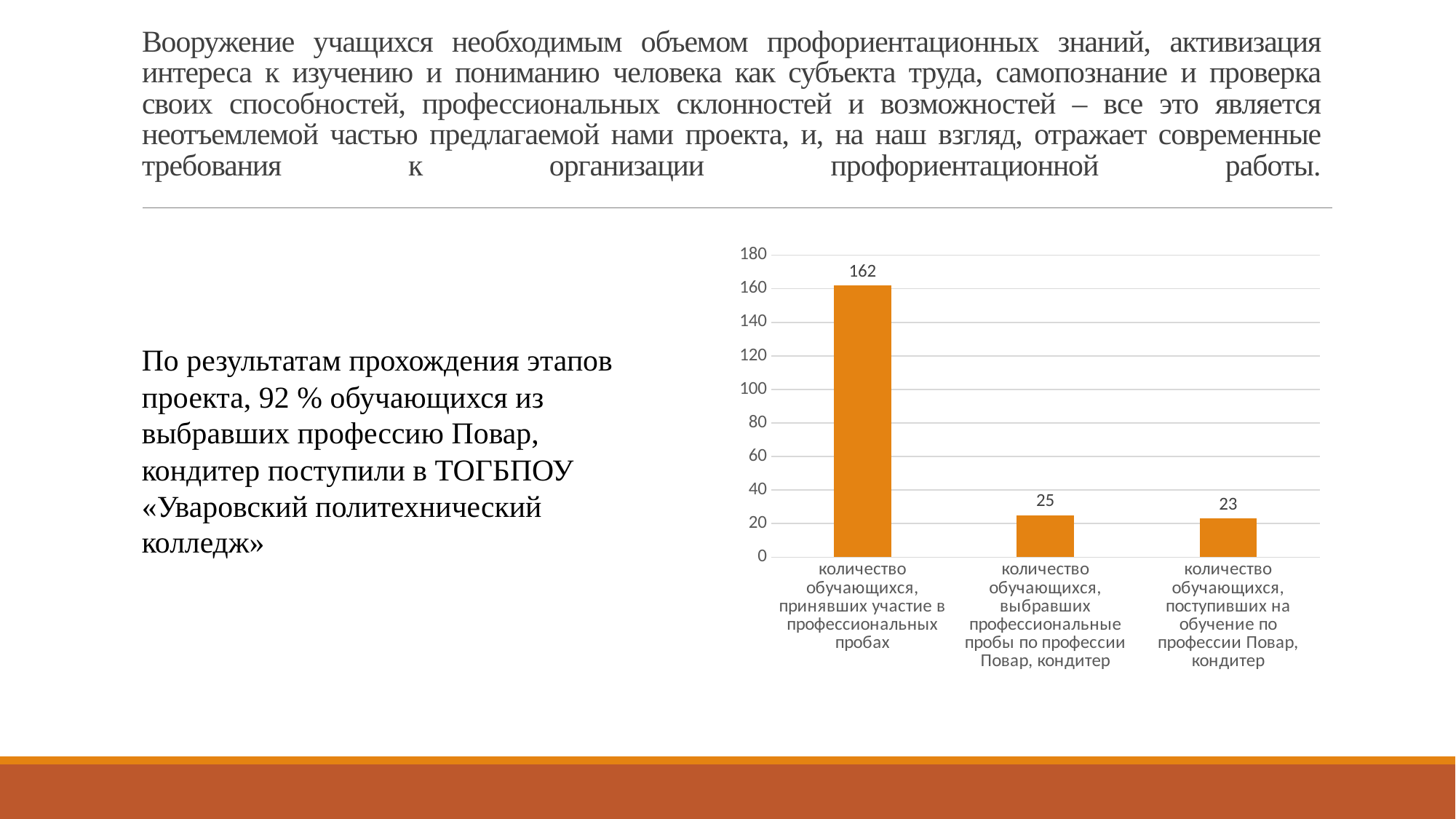
What kind of chart is shown on the slide? bar chart What is the value for the number of students who took part in professional trials (количество обучающихся, принявших участие в профессиональных пробах)? 162 What is the difference between the number of students who took part in professional trials and the number who chose trials in the profession Повар, кондитер? 137 What is the value for the number of students who chose professional trials in the profession Повар, кондитер? 25 Is the value for the number of students who took part in professional trials greater or less than 140? greater What colour are the bars in the chart? orange Which category has the lowest value? количество обучающихся, поступивших на обучение по профессии Повар, кондитер What is the difference between the number of students who chose trials in the profession Повар, кондитер and the number who enrolled in training for that profession? 2 How many categories are shown in the chart? 3 Which is larger: the number of students who chose trials in the profession Повар, кондитер or the number who enrolled in training for that profession? количество обучающихся, выбравших профессиональные пробы по профессии Повар, кондитер What is the value for the number of students who enrolled in training for the profession Повар, кондитер? 23 Which category has the highest value? количество обучающихся, принявших участие в профессиональных пробах